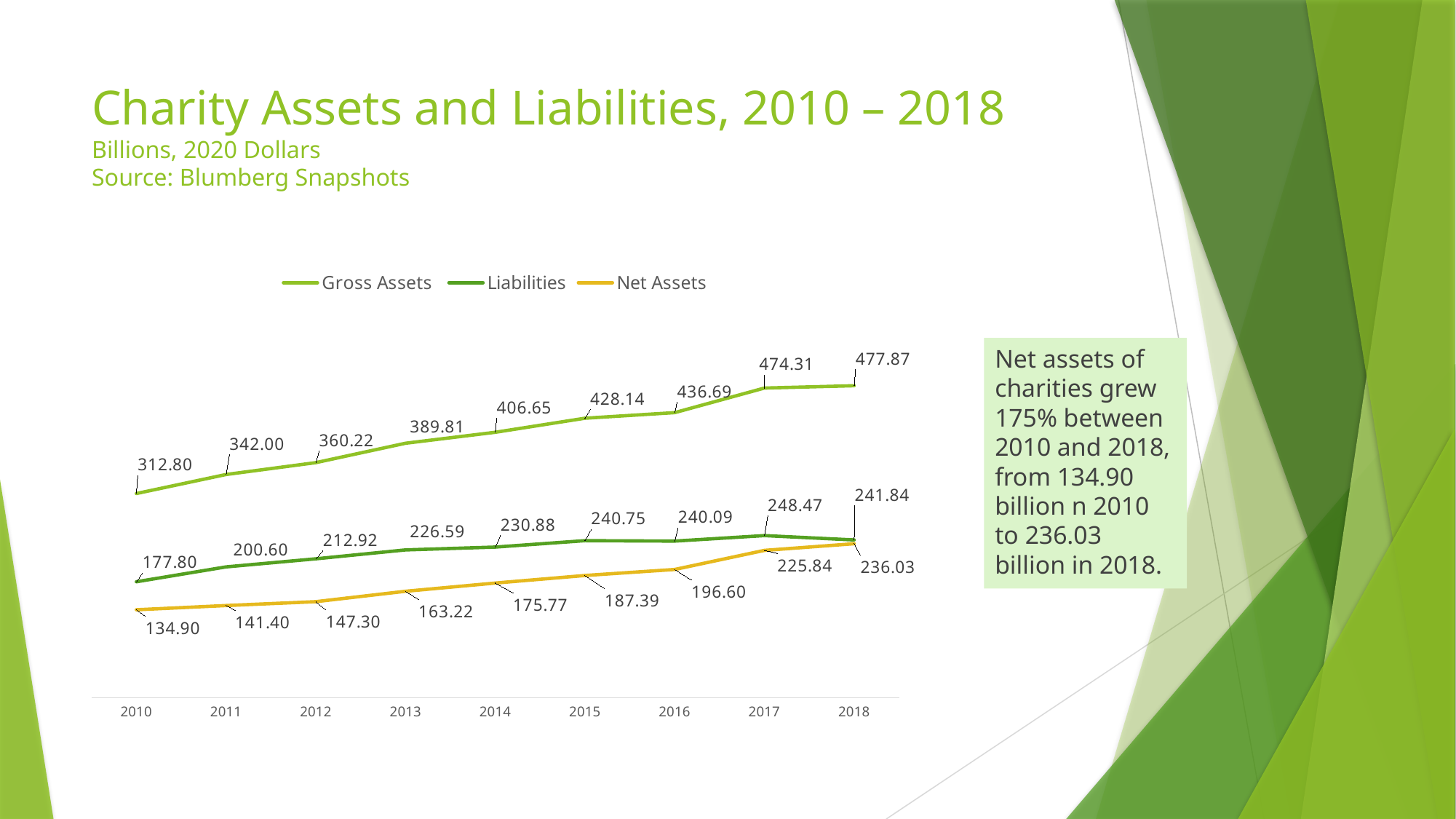
What is the difference between Gross Assets in 2018 and in 2010? 165.07 Which is larger in 2018, Liabilities or Net Assets? Liabilities What is the value of Gross Assets in 2014? 406.65 What is the value of Liabilities in 2011? 200.60 What is the difference between Liabilities in 2017 and in 2016? 8.38 Do Gross Assets rise or fall from 2010 to 2018? Rise How many series does the legend list? 3 In which year are Net Assets lowest? 2010 How many years are shown on the x axis? 9 What kind of chart is shown on the slide? Line chart What is the value of Net Assets in 2016? 196.60 In which year are Liabilities highest? 2017